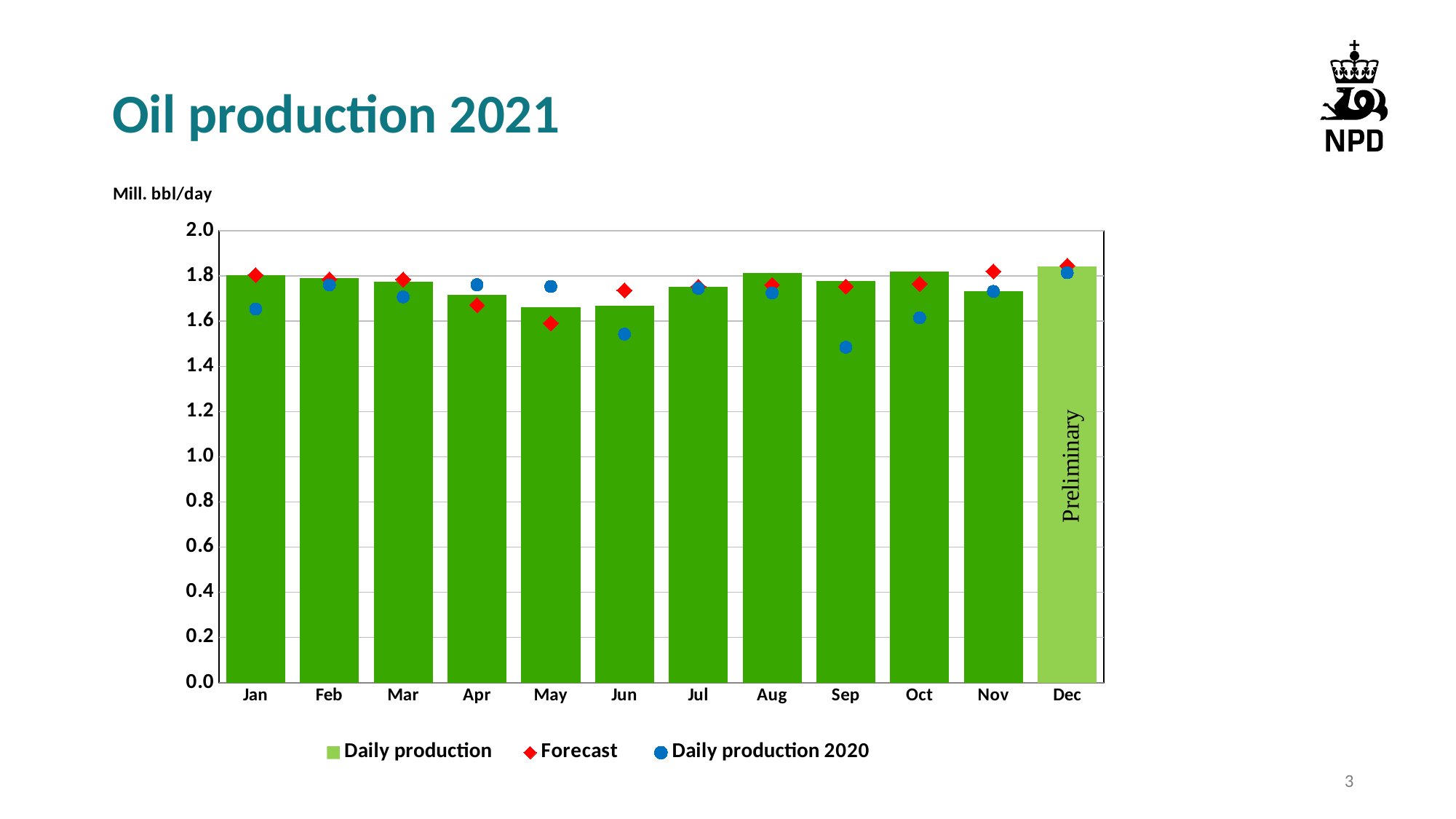
Is the Daily production value for May greater or less than 1.8? less What unit is shown above the y axis? Mill. bbl/day How many months are shown on the x axis? 12 For Sep, which is larger: Daily production or Daily production 2020? Daily production What kind of chart is shown on the slide? Bar chart Is the Forecast value for Apr greater or less than 1.8? less How many series does the legend list? 3 For Apr, which is larger: Forecast or Daily production 2020? Daily production 2020 Which month has the lowest Forecast value? May Is the Daily production value for Jan greater or less than 1.6? greater Which month has the lowest Daily production 2020 value? Sep